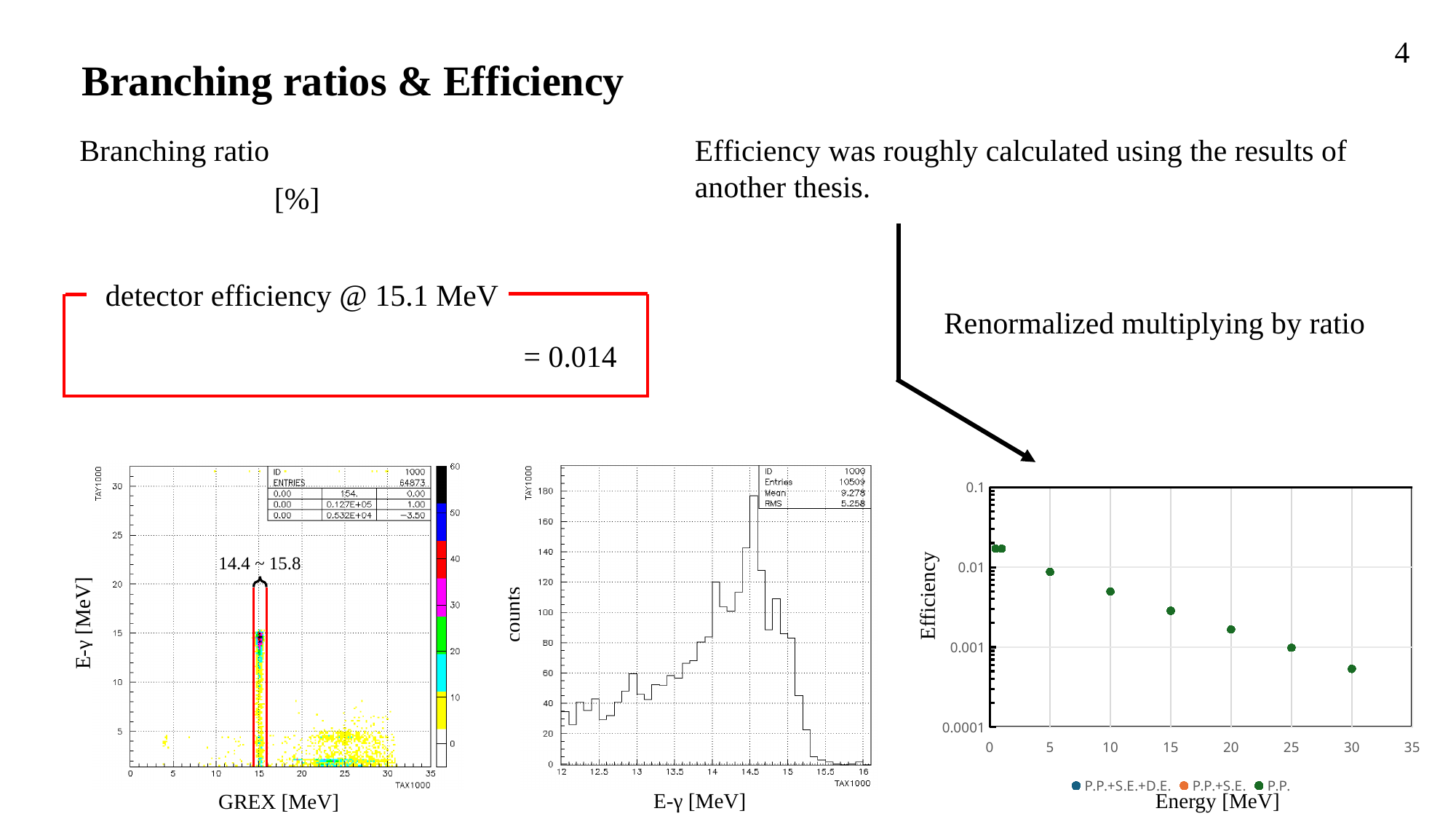
What are the three legend entries of the Efficiency chart on the right? P.P.+S.E.+D.E., P.P.+S.E., P.P. In the middle histogram of counts vs E-γ, how many entries does the statistics box report? 10509 What is the y-axis label of the Efficiency chart on the right of the slide? Efficiency In the Efficiency chart on the right, is the efficiency at 15 MeV greater or less than 0.001? greater What kind of chart is the Efficiency vs Energy chart on the right of the slide? scatter plot In the Efficiency chart on the right, which is larger: the efficiency at 10 MeV or at 25 MeV? 10 MeV How many series does the legend of the Efficiency chart on the right list? 3 In the Efficiency chart on the right, at which plotted energy is the efficiency lowest? 30 MeV In the Efficiency chart on the right, do the plotted values rise or fall as Energy increases? fall In the Efficiency chart on the right, is the efficiency at 30 MeV greater or less than 0.001? less In the middle histogram of counts vs E-γ, is the peak count greater or less than 160? greater